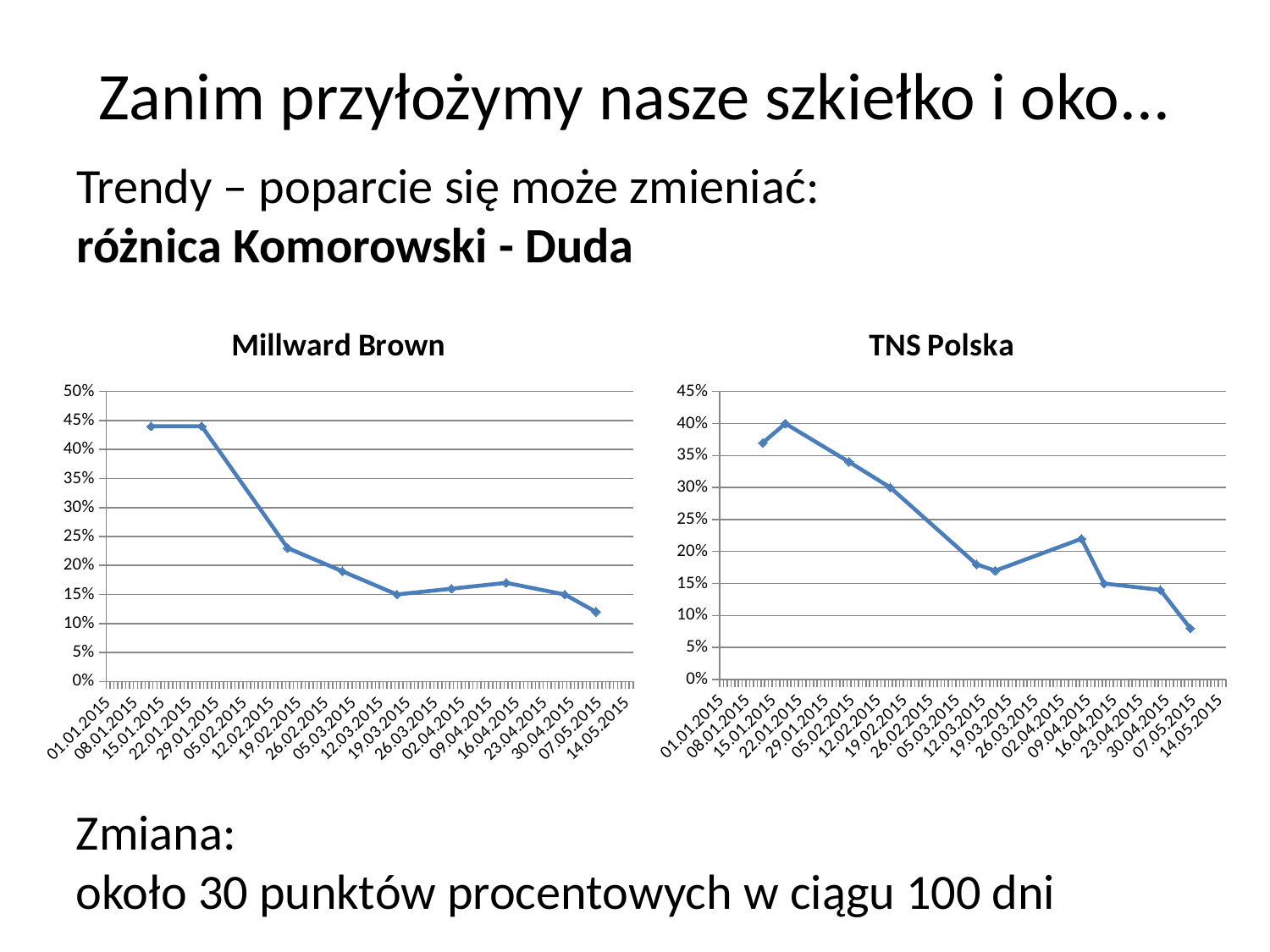
In the Millward Brown chart, which is larger, the first plotted value or the last plotted value? the first plotted value What is the highest value shown on the y axis of the TNS Polska chart? 45% In the TNS Polska chart, is the last plotted value greater or less than 10%? less What is the title of the chart on the left side of the slide? Millward Brown In the TNS Polska chart, which is larger, the first plotted value or the last plotted value? the first plotted value In the TNS Polska chart, do the values generally rise or fall along the x axis? fall In the Millward Brown chart, do the values generally rise or fall along the x axis? fall In the TNS Polska chart, is the highest plotted value greater or less than 35%? greater In the Millward Brown chart, is the highest plotted value greater or less than 40%? greater What type of chart is the TNS Polska chart? line chart What type of chart is the Millward Brown chart? line chart